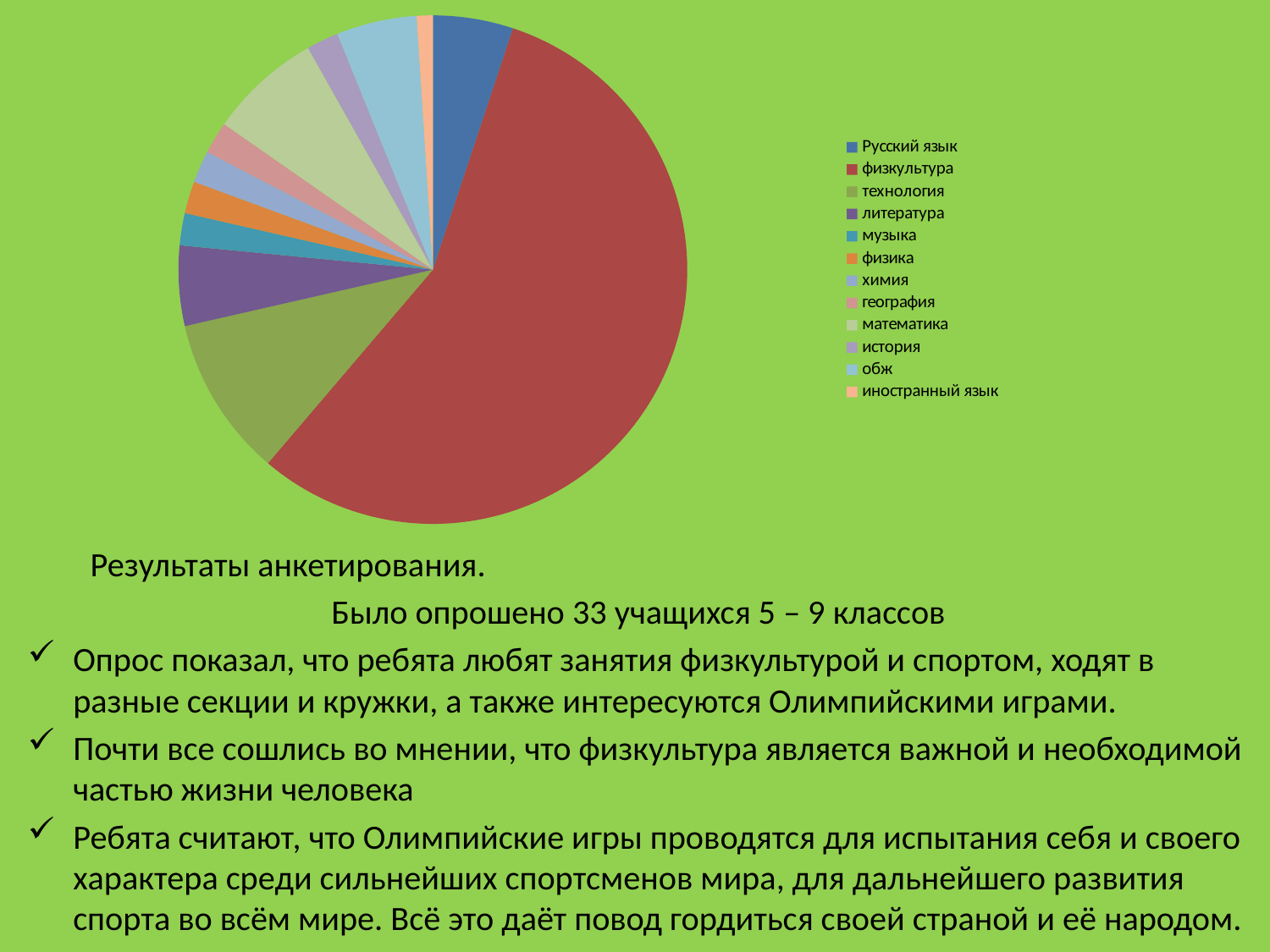
Which category is listed first in the legend of the pie chart? Русский язык Which slice is larger, физкультура or технология? физкультура Which category has the smallest slice of the pie chart? иностранный язык What colour is the физкультура slice in the pie chart? red Which slice is larger, математика or история? математика Does the физкультура slice take up more or less than half of the pie? more What kind of chart is shown on the slide? pie chart Which slice is larger, литература or музыка? литература Which category has the largest slice of the pie chart? физкультура How many categories does the legend of the pie chart list? 12